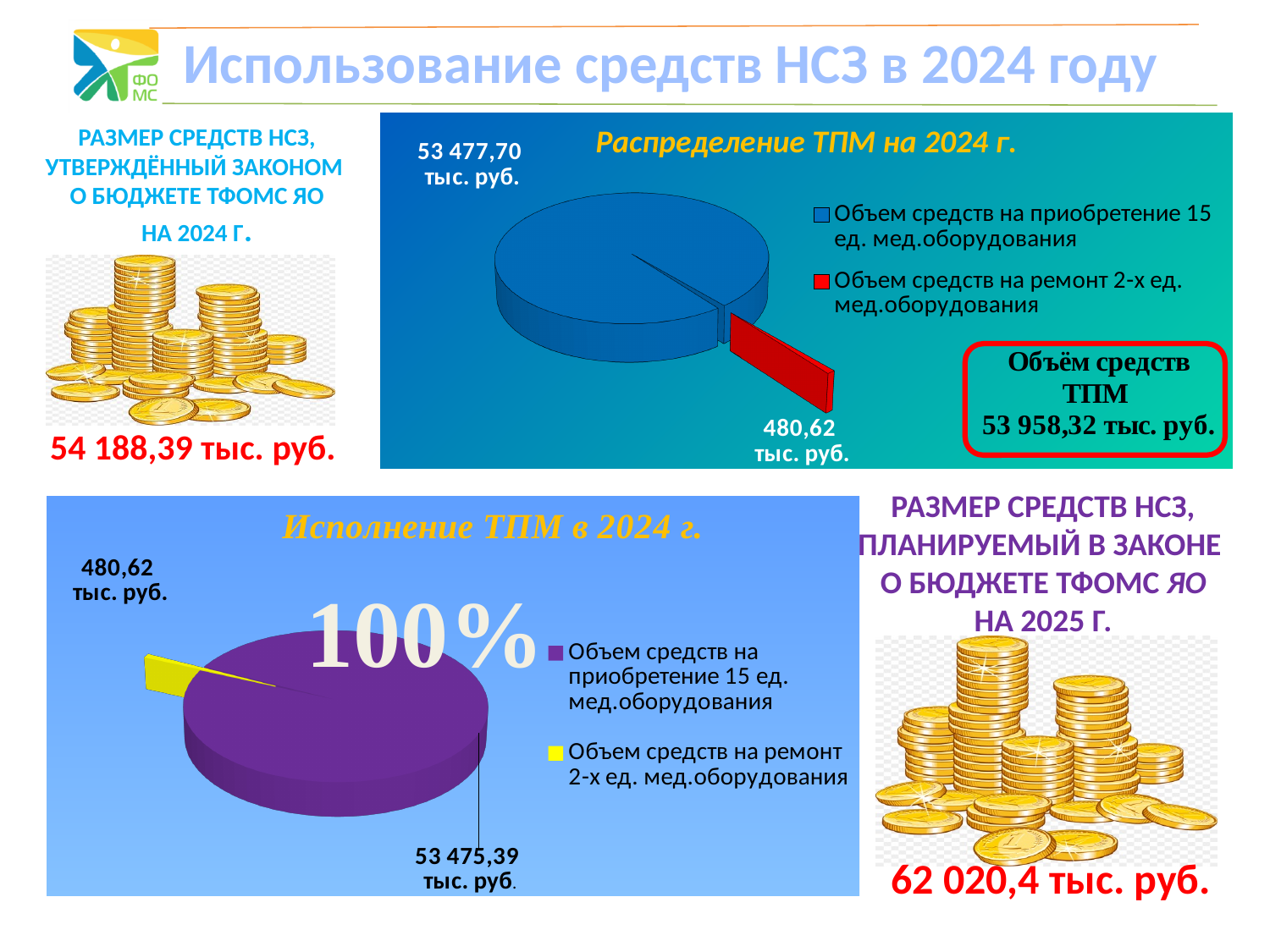
On the chart titled "Распределение ТПМ на 2024 г.", what is the total of the two slices (the total ТПМ funds shown on the slide)? 53 958,32 тыс. руб. On the chart titled "Исполнение ТПМ в 2024 г.", what colour is the slice for "Объем средств на ремонт 2-х ед. мед.оборудования"? Yellow On the chart titled "Распределение ТПМ на 2024 г.", what is the difference between the value for purchasing 15 units of medical equipment and the value for repairing 2 units? 52 997,08 тыс. руб. On the chart titled "Распределение ТПМ на 2024 г.", what is the value for "Объем средств на ремонт 2-х ед. мед.оборудования"? 480,62 тыс. руб. How many slices does the chart titled "Распределение ТПМ на 2024 г." have? 2 On the chart titled "Исполнение ТПМ в 2024 г.", which category has the smallest slice? Объем средств на ремонт 2-х ед. мед.оборудования What kind of chart is "Исполнение ТПМ в 2024 г."? Pie chart On the chart titled "Распределение ТПМ на 2024 г.", which category has the largest slice? Объем средств на приобретение 15 ед. мед.оборудования On the chart titled "Исполнение ТПМ в 2024 г.", what is the value for "Объем средств на ремонт 2-х ед. мед.оборудования"? 480,62 тыс. руб. On the chart titled "Исполнение ТПМ в 2024 г.", what is the value for "Объем средств на приобретение 15 ед. мед.оборудования"? 53 475,39 тыс. руб. On the chart titled "Распределение ТПМ на 2024 г.", what is the value for "Объем средств на приобретение 15 ед. мед.оборудования"? 53 477,70 тыс. руб. On the chart titled "Исполнение ТПМ в 2024 г.", what is the difference between the value for purchasing 15 units of medical equipment and the value for repairing 2 units? 52 994,77 тыс. руб.